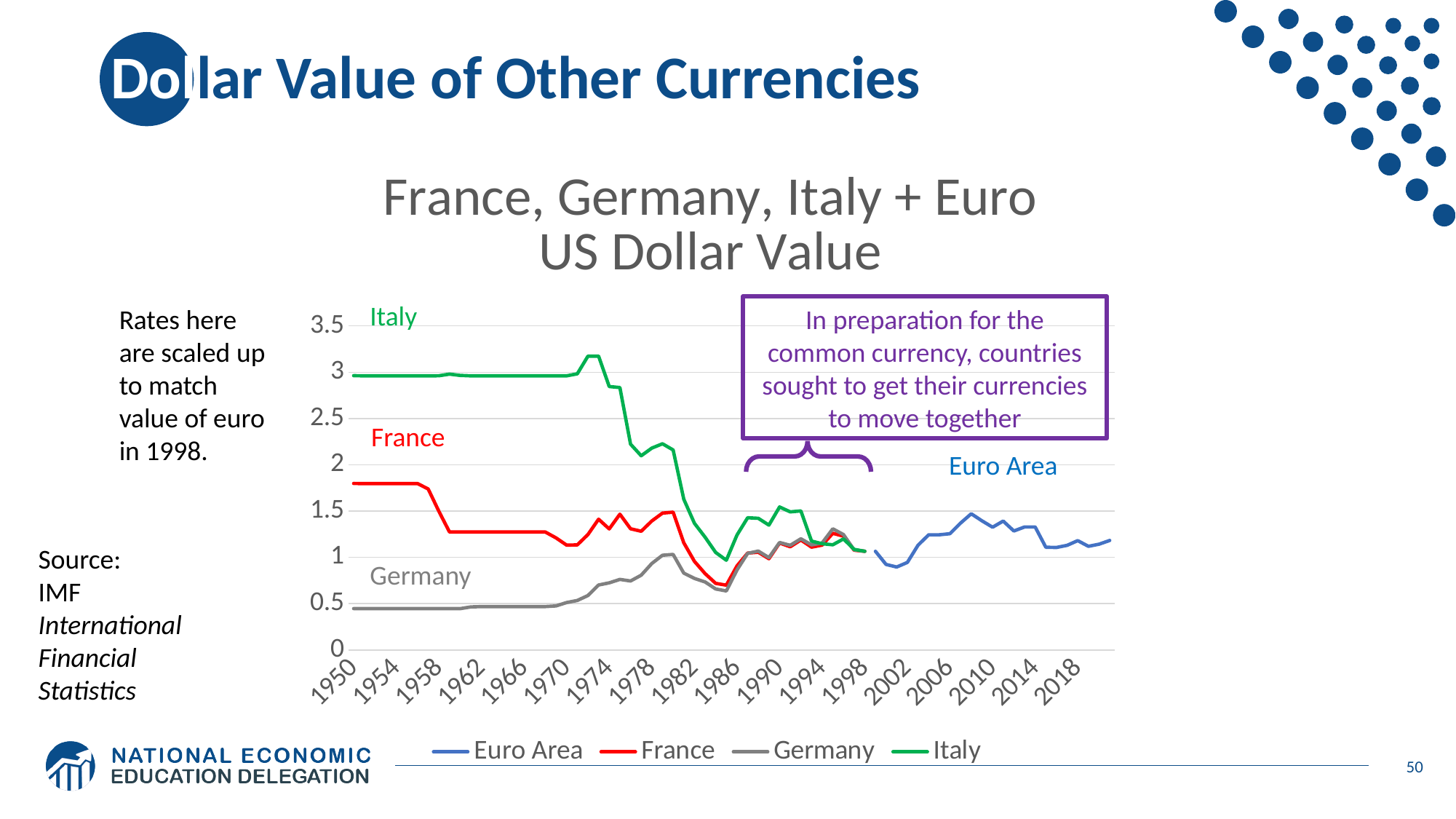
Is the value for Germany in 1950 greater or less than 1? less Is the value for Italy in 1950 greater or less than 2.5? greater Which series is the only one plotted after 1998? Euro Area How many series does the chart legend list? 4 In 1950, which is higher, France or Germany? France Is the value for France in 1950 greater or less than 1.5? greater What is the title of the chart? France, Germany, Italy + Euro US Dollar Value Does the Italy line rise or fall overall between 1950 and 1998? fall What kind of chart is shown on the slide? line chart Which series has the lowest value in 1950? Germany Which series has the highest value in 1950? Italy